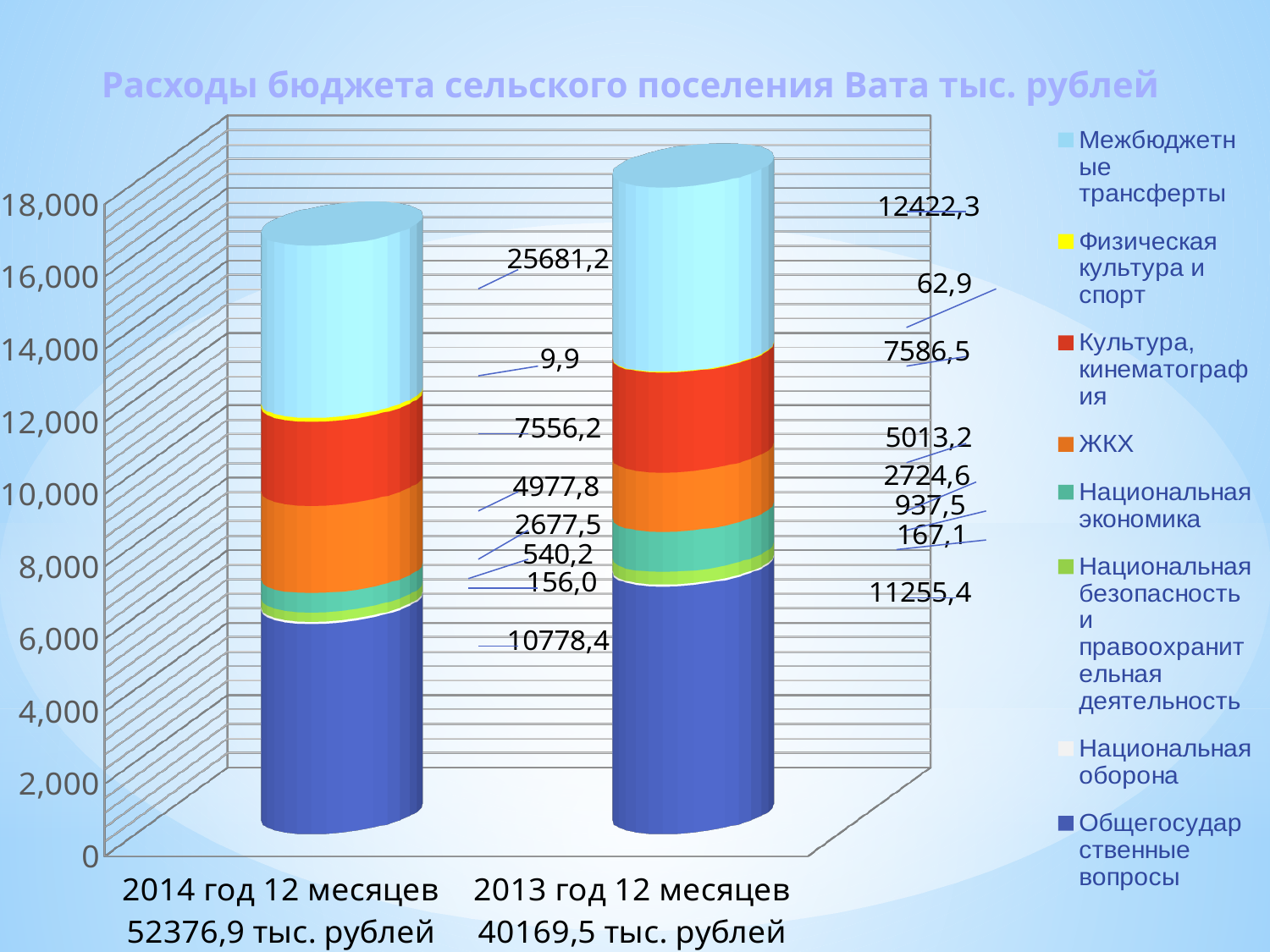
Which year has the larger value for Межбюджетные трансферты, 2014 or 2013? 2014 What is the value of Физическая культура и спорт for 2013 год 12 месяцев? 62,9 What is the value of Общегосударственные вопросы for 2013 год 12 месяцев? 11255,4 What is the value of Межбюджетные трансферты for 2014 год 12 месяцев? 25681,2 What kind of chart is shown on the slide? bar chart What is the difference between the Национальная оборона values for 2013 (167,1) and 2014 (156,0)? 11,1 What is the value of Межбюджетные трансферты for 2013 год 12 месяцев? 12422,3 How many categories (bars) are plotted on the chart? 2 What total expenditure is shown for 2013 год 12 месяцев? 40169,5 тыс. рублей What is the title of the chart? Расходы бюджета сельского поселения Вата тыс. рублей How many series does the legend list? 8 What is the value of ЖКХ for 2014 год 12 месяцев? 4977,8